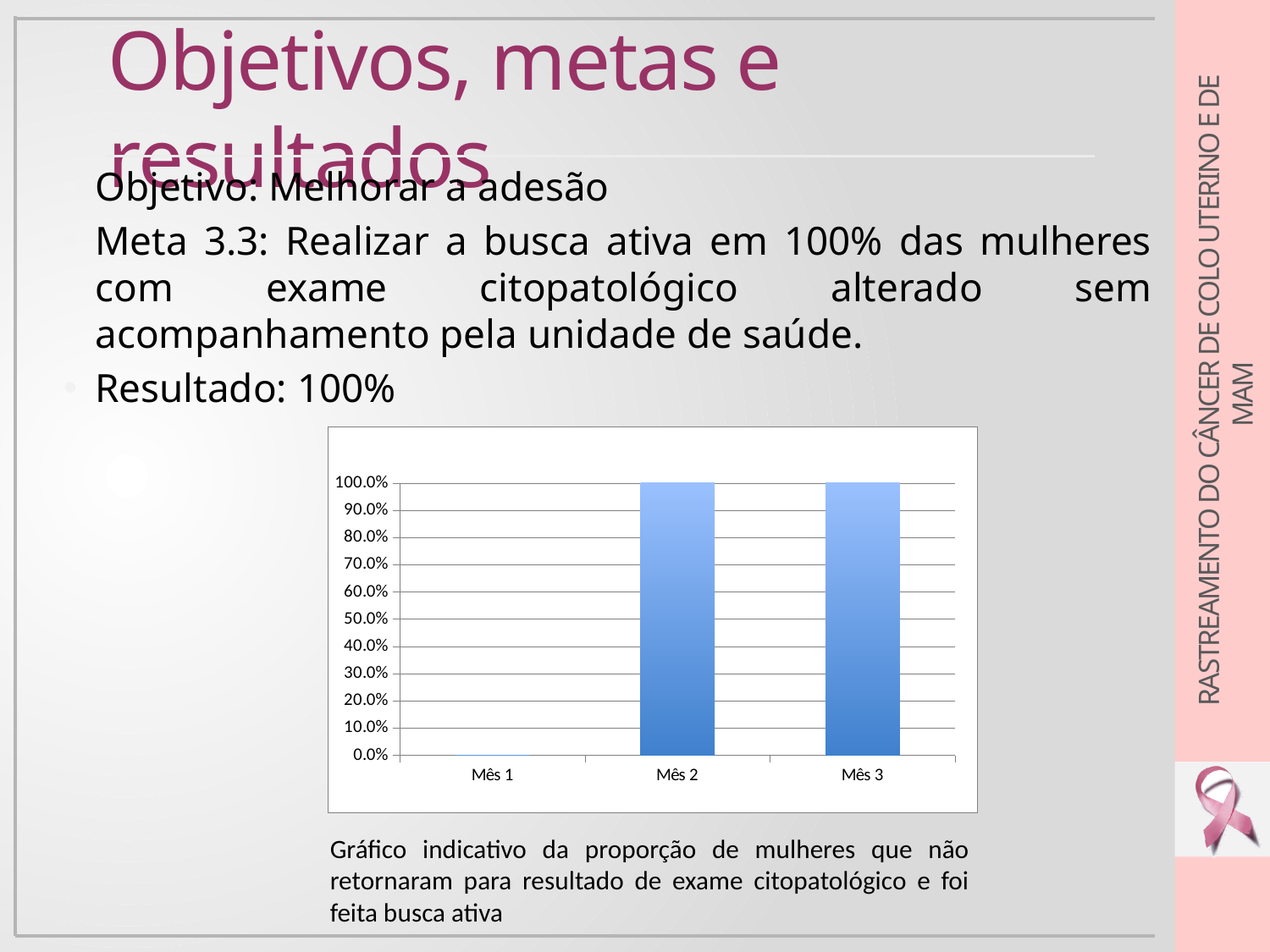
Is the value for Mês 1 greater or less than 10.0%? less What is the label of the first category on the x axis? Mês 1 What is the value for Mês 2 in the chart? 100.0% What is the value for Mês 3 in the chart? 100.0% Which month has the lowest value in the chart? Mês 1 Which is larger in the chart, the value for Mês 1 or the value for Mês 2? Mês 2 What is the highest tick value shown on the y axis of the chart? 100.0% Does the value rise or fall from Mês 1 to Mês 2? rise How many categories are shown on the x axis of the chart? 3 Is the value for Mês 3 greater or less than 90.0%? greater What is the difference between the values for Mês 2 and Mês 3? 0.0% What type of chart is shown on the slide? bar chart